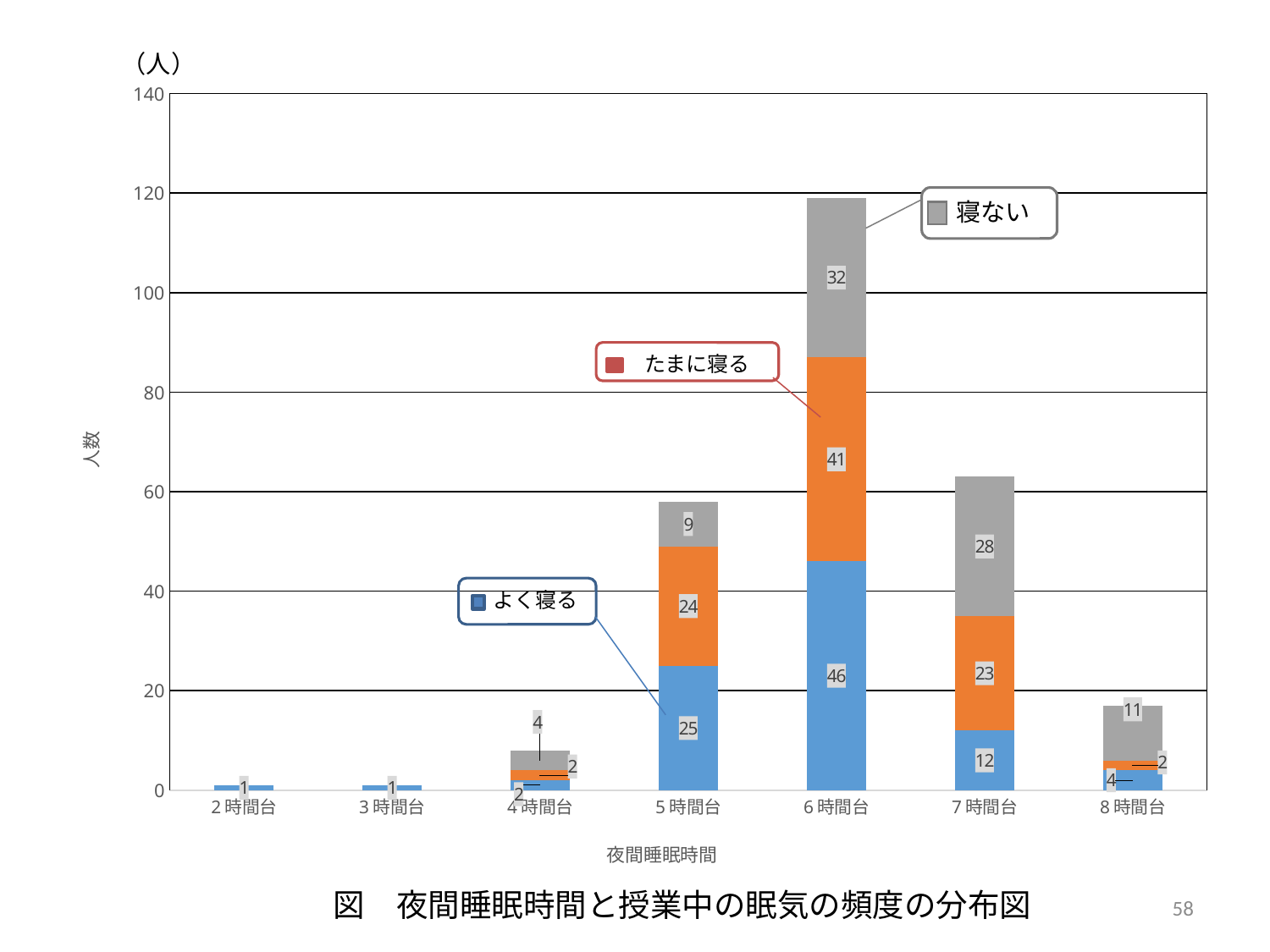
Is the total stacked bar for 7時間台 greater or less than 60? greater What is the total of the stacked bar for 6時間台? 119 How many series does the chart show? 3 What is the difference between よく寝る for 6時間台 and よく寝る for 5時間台? 21 What is the value of たまに寝る for 5時間台? 24 How many categories are shown on the x axis? 7 Which is larger: たまに寝る for 7時間台 or 寝ない for 7時間台? 寝ない for 7時間台 What is the total of the stacked bar for 5時間台? 58 Which category has the tallest stacked bar? 6時間台 What is the value of よく寝る for 6時間台? 46 What kind of chart is this? stacked bar chart What is the value of 寝ない for 7時間台? 28